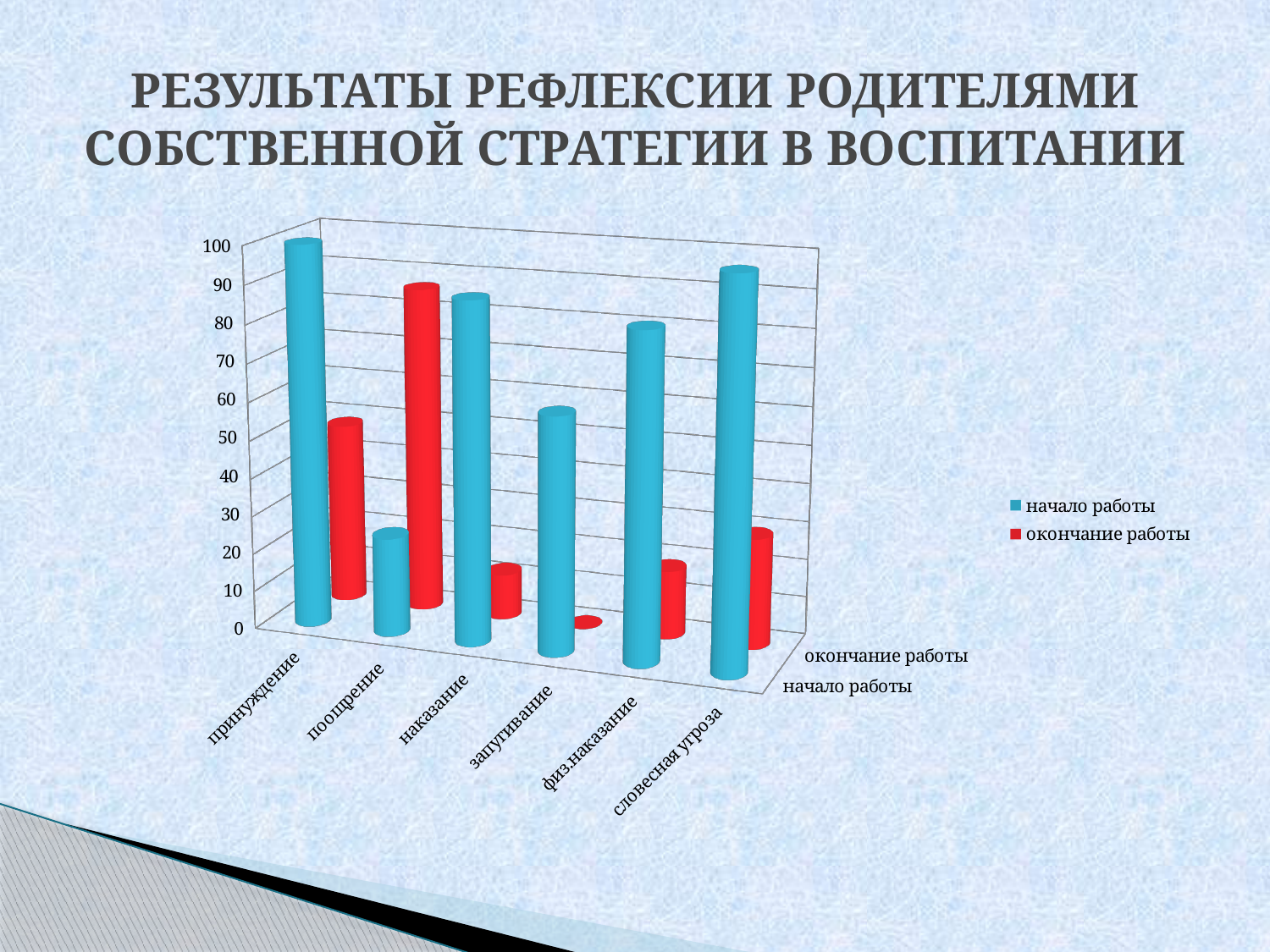
Is the value for 'запугивание' in the series 'окончание работы' greater or less than 10? less Is the value for 'принуждение' in the series 'начало работы' greater or less than 90? greater How many categories are shown along the x axis of the chart? 6 How many series does the legend list? 2 Which category has the lowest value for the series 'окончание работы'? запугивание What kind of chart is shown on the slide? bar chart Which category has the highest value for the series 'окончание работы'? поощрение Which category has the lowest value for the series 'начало работы'? поощрение Which colour represents the series 'окончание работы' in the chart? red For 'наказание', which series has the larger value: 'начало работы' or 'окончание работы'? начало работы For 'поощрение', which series has the larger value: 'начало работы' or 'окончание работы'? окончание работы